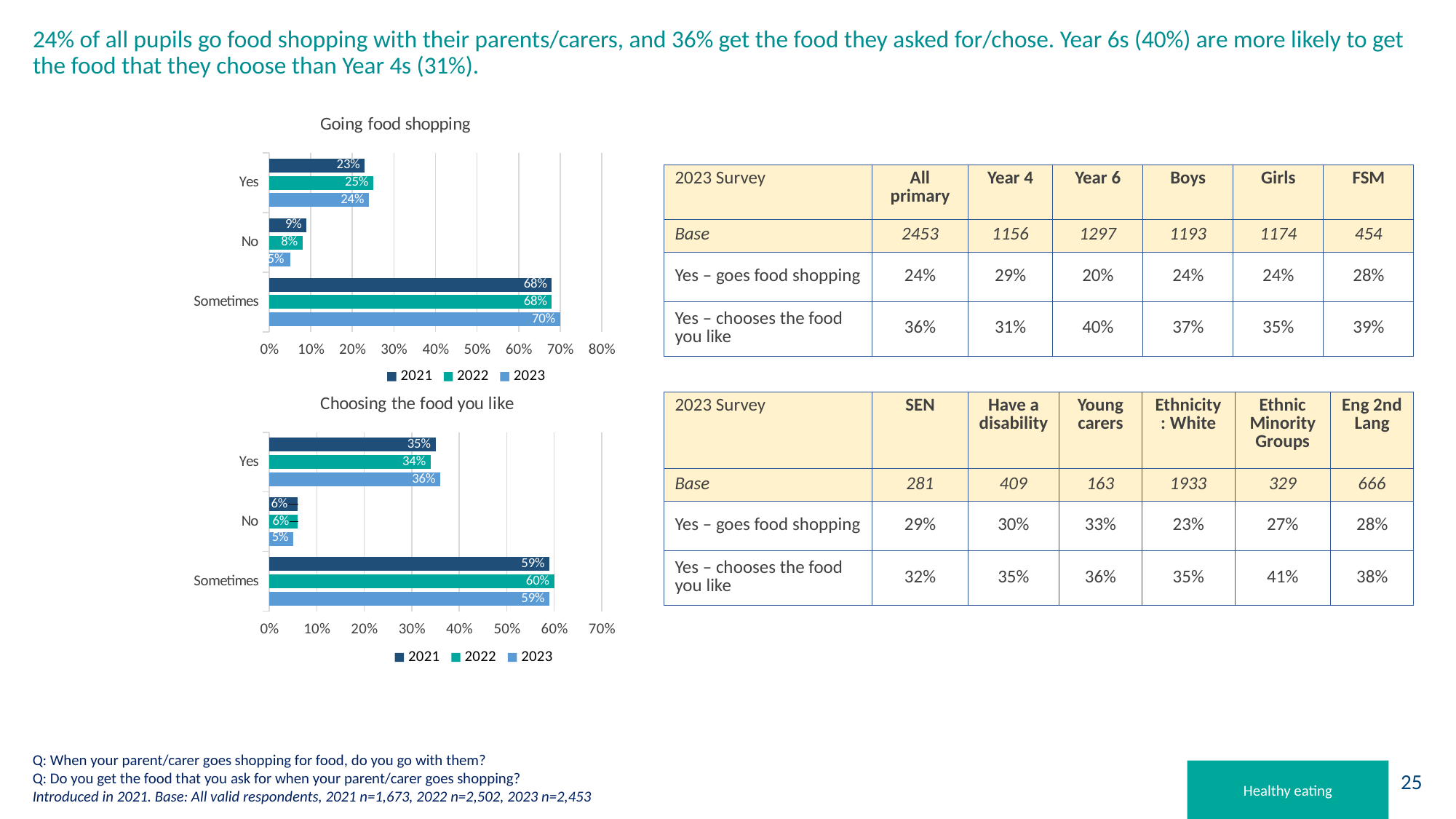
In the 'Choosing the food you like' chart, is the 2023 value for Sometimes greater or less than 50%? greater In the 'Going food shopping' chart, which category has the lowest 2023 value? No In the 'Choosing the food you like' chart, which category has the highest 2022 value? Sometimes What type of chart is the 'Choosing the food you like' chart? Bar chart In the 'Going food shopping' chart, what is the 2023 value for Sometimes? 70% In the 'Going food shopping' chart, what is the difference between the 2021 and 2023 values for No? 4% In the 'Choosing the food you like' chart, what is the 2022 value for Sometimes? 60% In the 'Going food shopping' chart, what is the 2021 value for No? 9% In the 'Choosing the food you like' chart, what is the 2023 value for Yes? 36% How many series does the legend of the 'Going food shopping' chart list? 3 In the 'Going food shopping' chart, what is the 2023 value for Yes? 24% In the 'Choosing the food you like' chart, which is larger: the 2021 value for Yes or the 2021 value for No? Yes